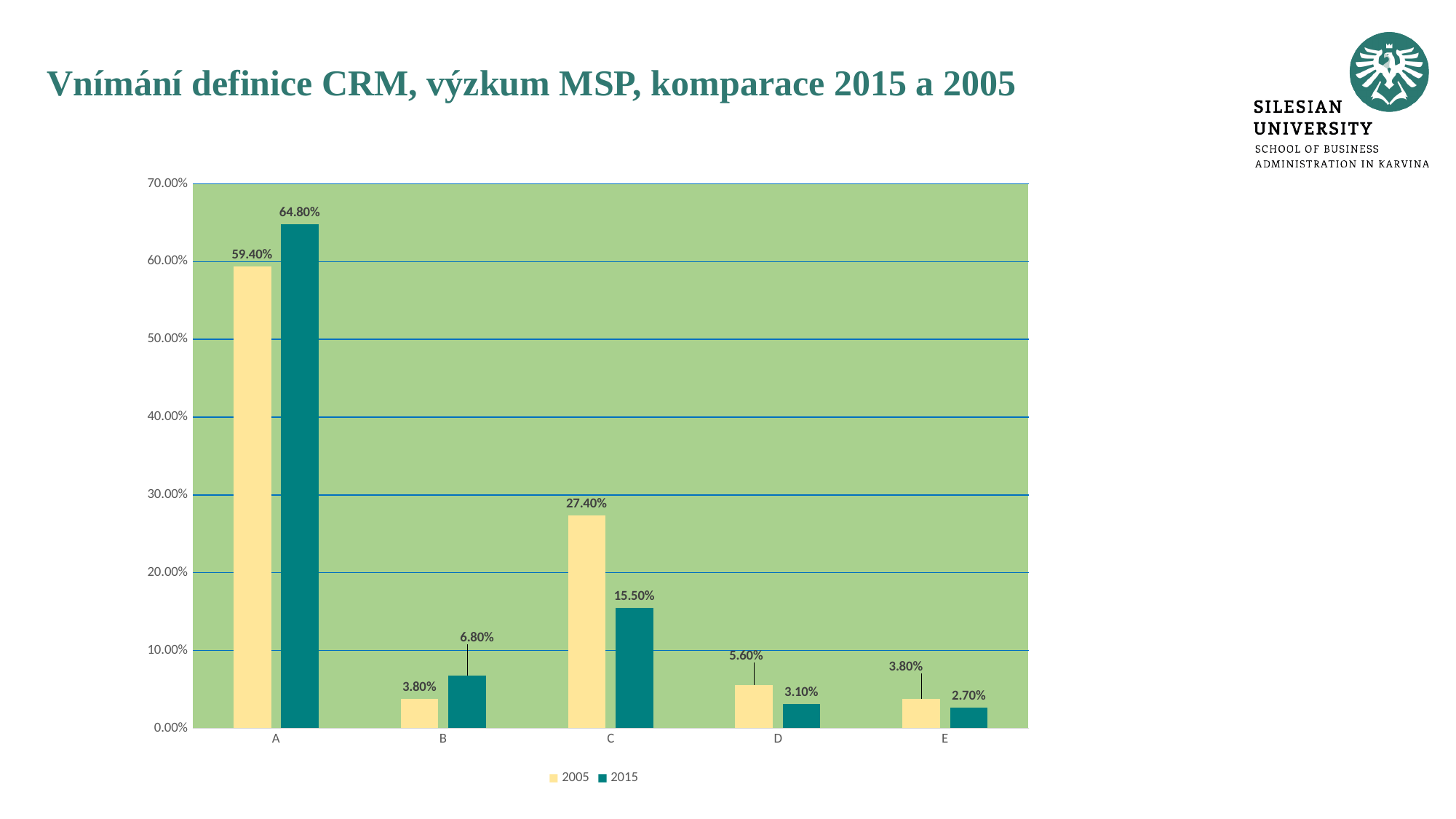
What is the value for category A in the 2015 series? 64.80% What kind of chart is shown on the slide? bar chart What is the value for category D in the 2015 series? 3.10% What is the value for category C in the 2005 series? 27.40% How many series does the legend list? 2 Is the 2005 value for category C greater or less than 30.00%? less Which category has the highest value in the 2005 series? A For category B, which series has the larger value, 2005 or 2015? 2015 How many categories are shown on the x axis? 5 Which category has the lowest value in the 2015 series? E What is the difference between the 2005 and 2015 values for category C? 11.90% What is the difference between the 2015 and 2005 values for category A? 5.40%